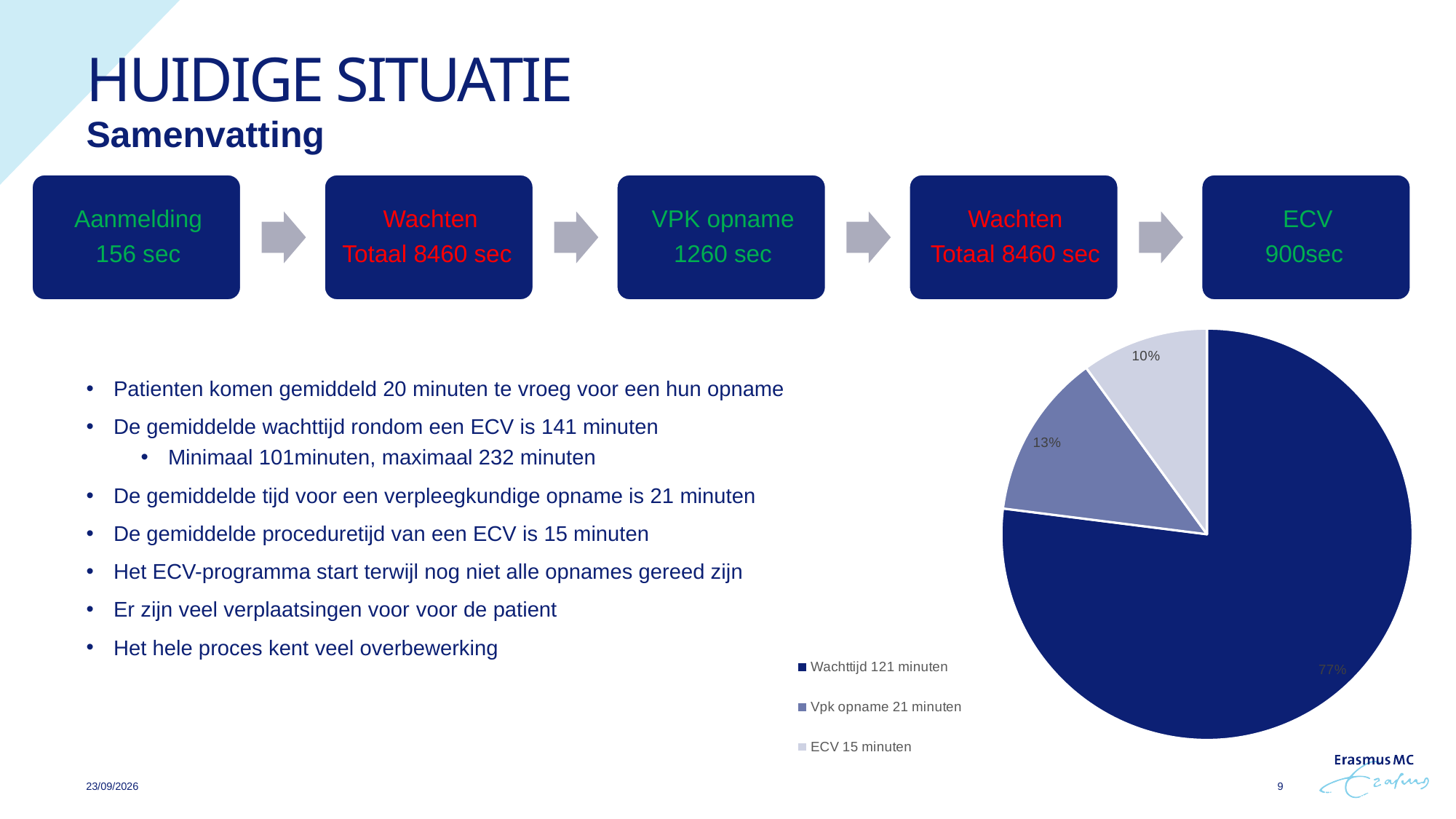
Which slice of the pie chart is the largest? Wachttijd 121 minuten What share of the pie does the 'Wachttijd 121 minuten' slice represent? 77% What is the combined share of the 'Vpk opname 21 minuten' and 'ECV 15 minuten' slices? 23% How many entries does the pie chart's legend list? 3 What share of the pie does the 'ECV 15 minuten' slice represent? 10% Which legend entry of the pie chart is shown in the darkest blue colour? Wachttijd 121 minuten Which slice is larger: 'Vpk opname 21 minuten' or 'ECV 15 minuten'? Vpk opname 21 minuten How many slices does the pie chart have? 3 Which slice of the pie chart is the smallest? ECV 15 minuten What kind of chart is shown on the slide? pie chart What is the difference in percentage points between the 'Wachttijd 121 minuten' slice and the 'Vpk opname 21 minuten' slice? 64 What share of the pie does the 'Vpk opname 21 minuten' slice represent? 13%